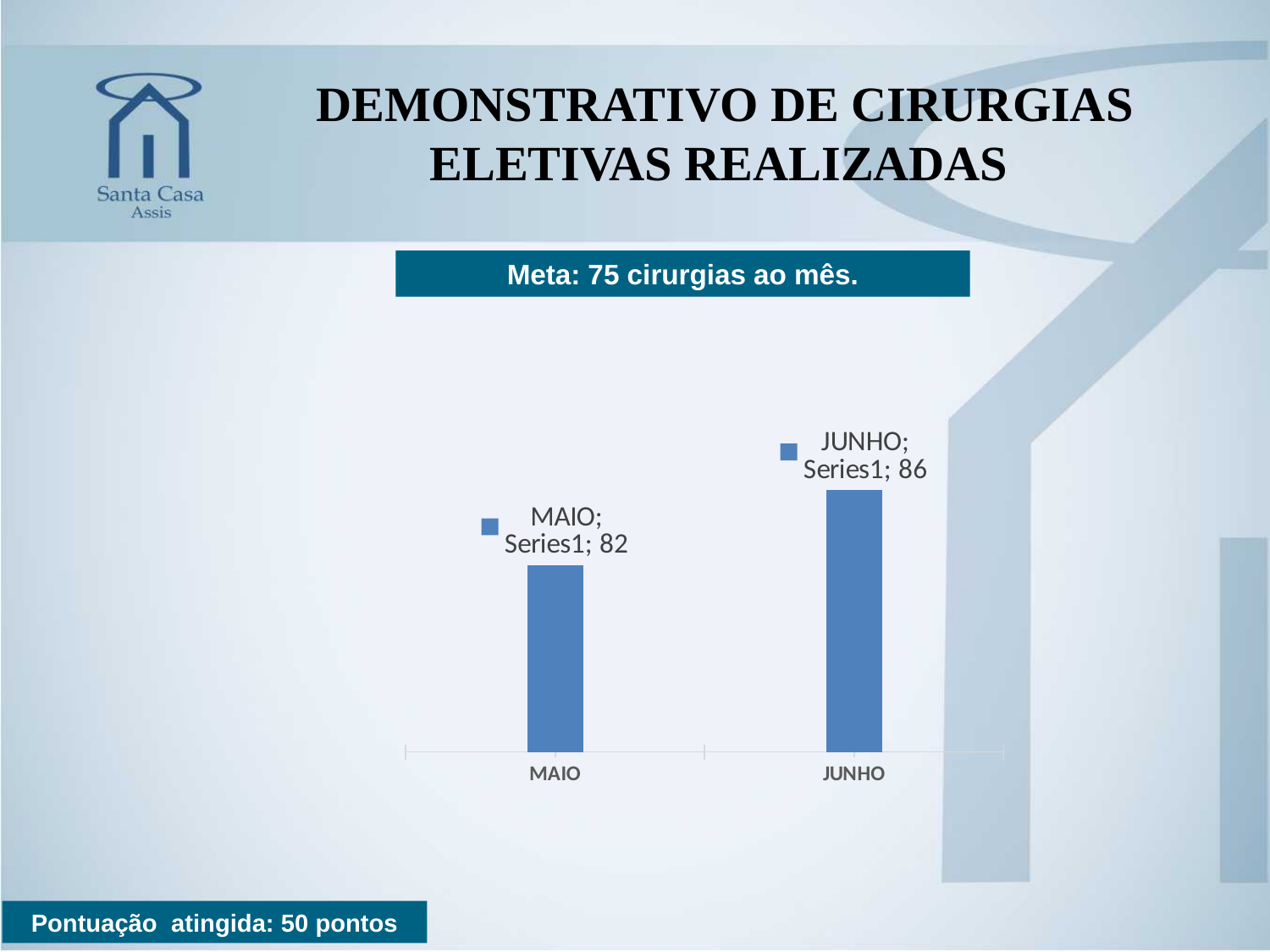
What is the value for JUNHO? 86 Do the values rise or fall from MAIO to JUNHO? Rise What is the name of the series shown in the data labels? Series1 Which month has the highest value? JUNHO What is the total of the values for MAIO and JUNHO? 168 Which month has the lowest value? MAIO What is the difference between the values for JUNHO and MAIO? 4 How many categories are shown on the x axis? 2 What kind of chart is shown on the slide? Bar chart Which is larger, the value for MAIO or the value for JUNHO? JUNHO What is the value for MAIO? 82 What monthly target (meta) is stated above the chart? 75 cirurgias ao mês